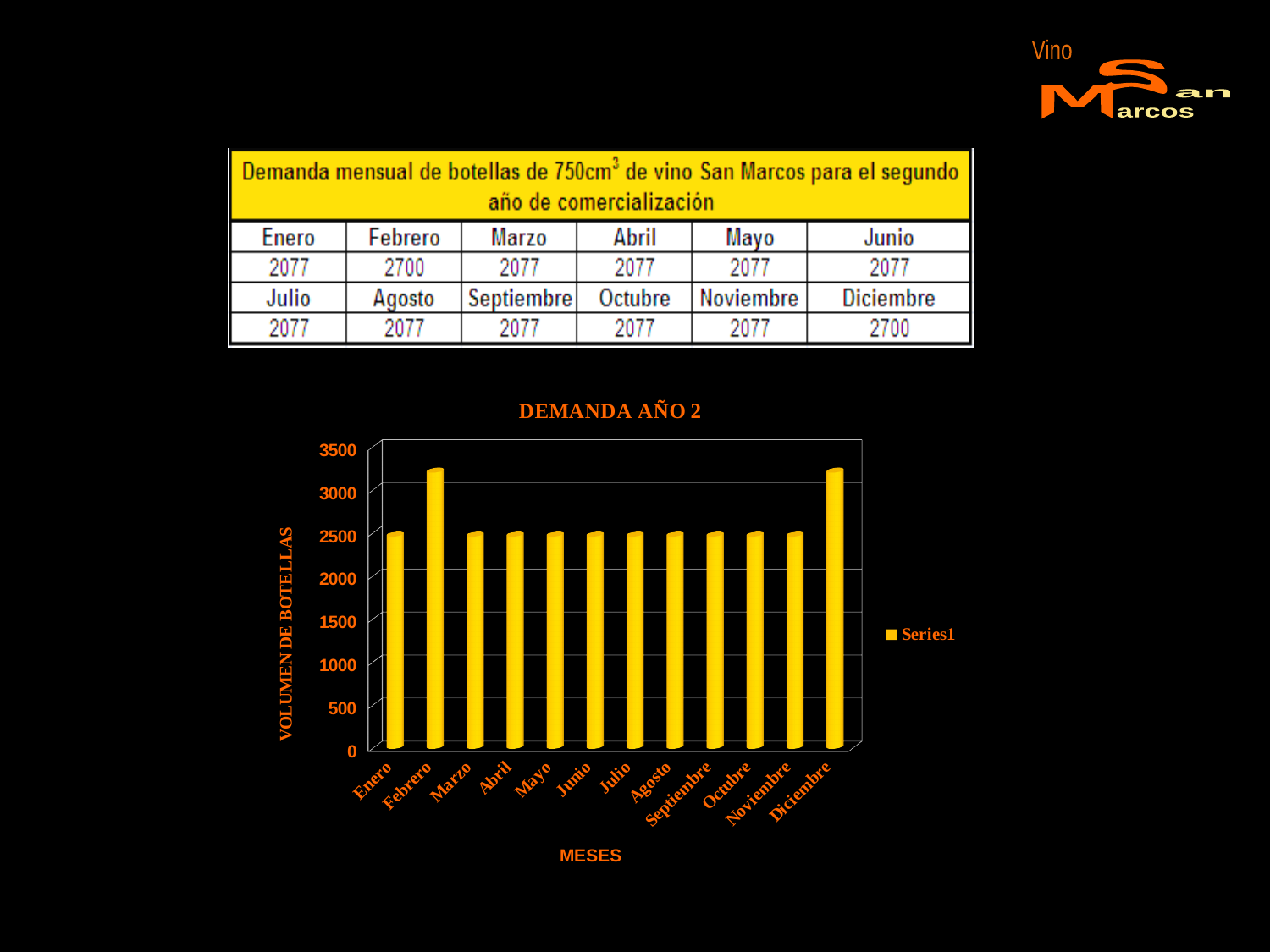
Is the value for Enero in the DEMANDA AÑO 2 chart greater or less than 2000? greater Is the value for Febrero in the DEMANDA AÑO 2 chart greater or less than 3000? greater Is the value for Enero in the DEMANDA AÑO 2 chart greater or less than 3000? less What kind of chart is shown under the title DEMANDA AÑO 2? bar chart How many series does the legend of the DEMANDA AÑO 2 chart list? 1 In the DEMANDA AÑO 2 chart, which is larger, the bar for Febrero or the bar for Marzo? Febrero What is the title of the chart on the slide? DEMANDA AÑO 2 What is the name of the series shown in the legend of the DEMANDA AÑO 2 chart? Series1 How many months are plotted on the x axis of the DEMANDA AÑO 2 chart? 12 In the DEMANDA AÑO 2 chart, which is larger, the bar for Noviembre or the bar for Diciembre? Diciembre